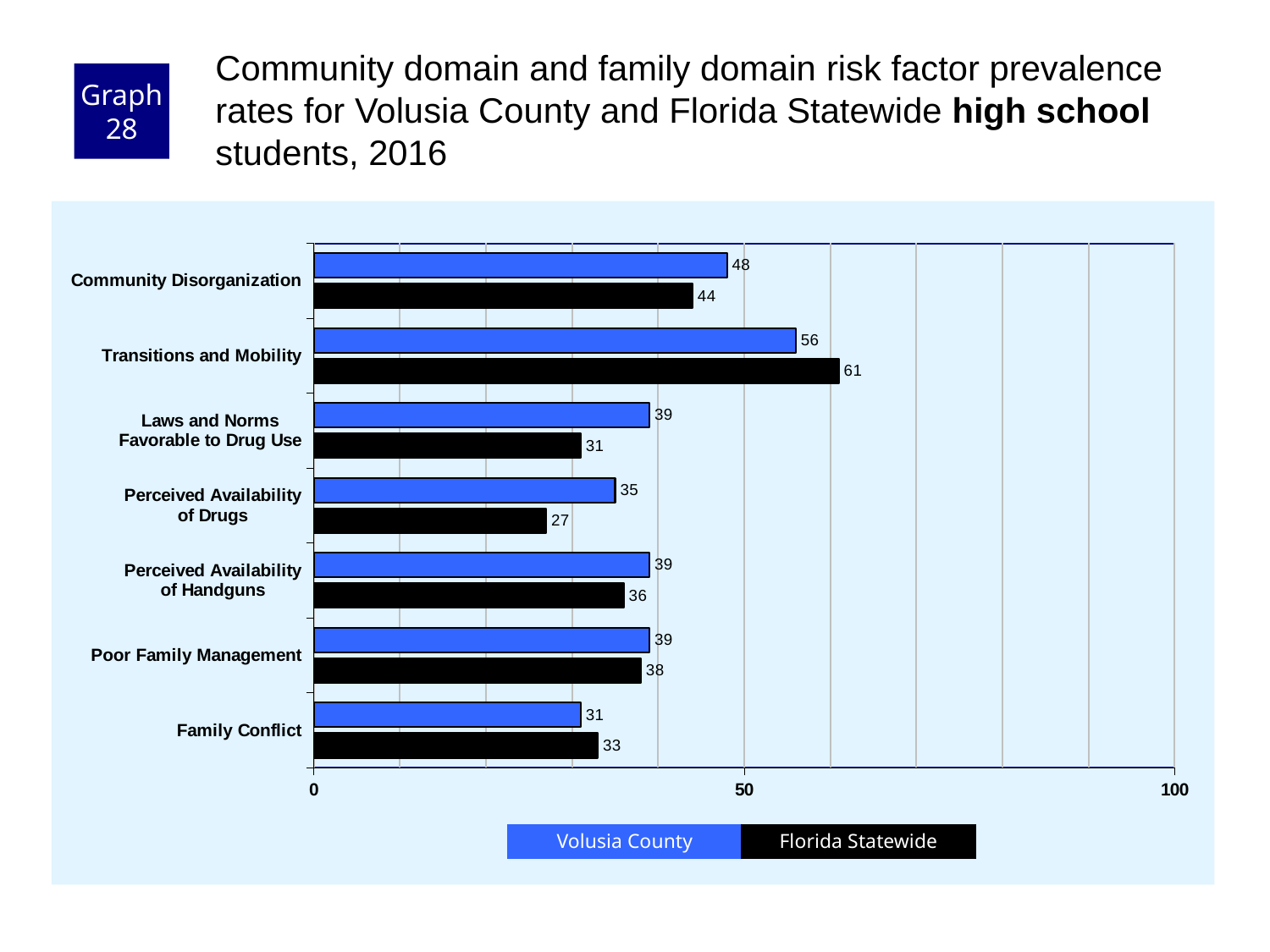
How many series does the legend list? 2 How many risk factor categories are shown on the chart? 7 What is the Florida Statewide value for Perceived Availability of Drugs? 27 Which colour represents Florida Statewide in the chart? black Which risk factor has the highest Volusia County value? Transitions and Mobility For Family Conflict, which is larger: the Volusia County value or the Florida Statewide value? Florida Statewide Is the Volusia County value for Transitions and Mobility greater or less than 50? greater What kind of chart is shown on the slide? bar chart Which risk factor has the lowest Florida Statewide value? Perceived Availability of Drugs What is the difference between the Volusia County and Florida Statewide values for Laws and Norms Favorable to Drug Use? 8 What is the Florida Statewide value for Transitions and Mobility? 61 What is the Volusia County value for Community Disorganization? 48